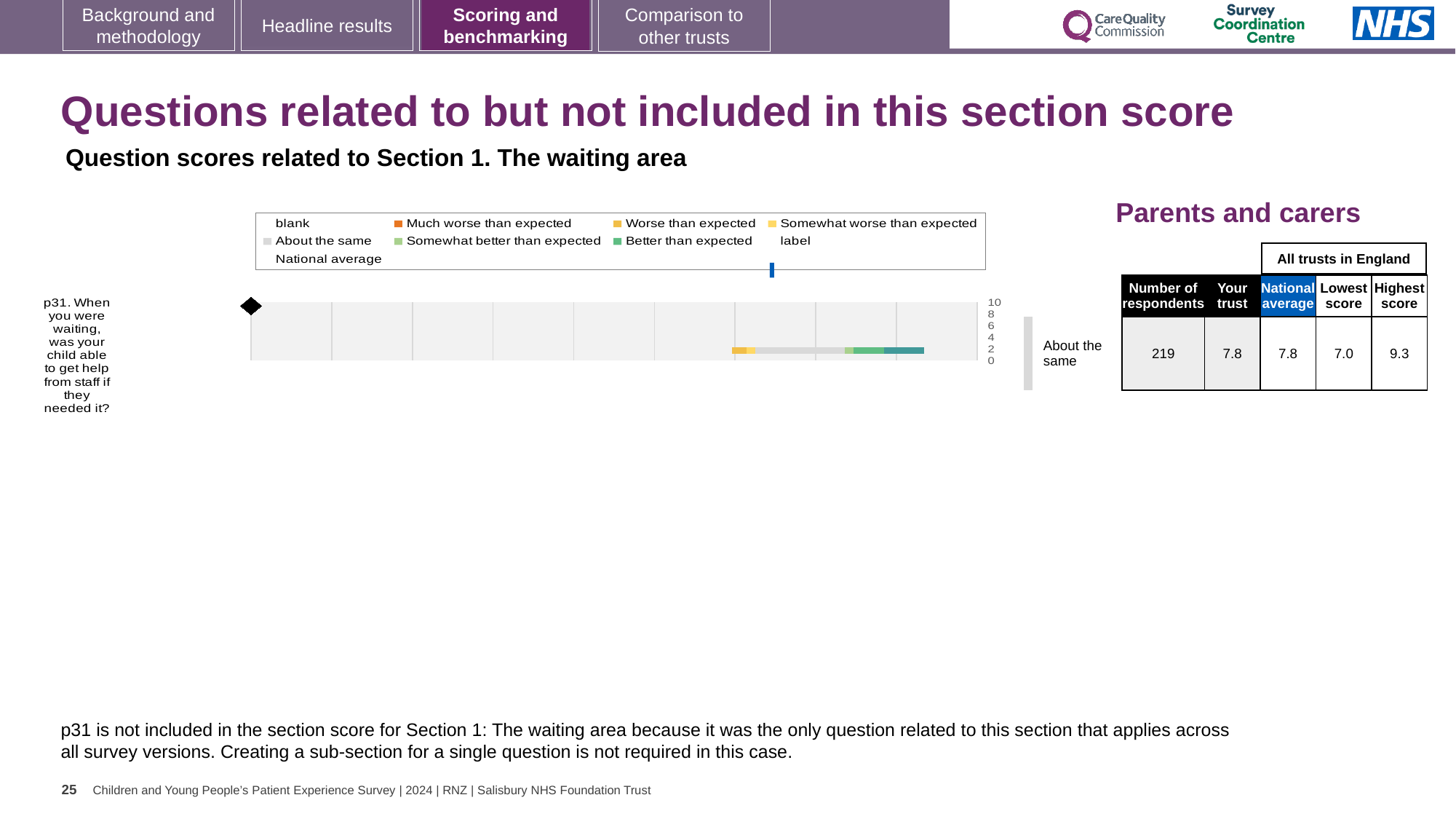
According to the table beside the chart, what is the National average score for p31? 7.8 What is the difference between the Highest score and the Your trust score for p31? 1.5 How many respondents answered question p31? 219 What is the subtitle above the chart describing which section the question scores relate to? Question scores related to Section 1. The waiting area What kind of chart is used to show the score for question p31? bar chart What is the difference between the Highest score and the Lowest score for p31? 2.3 According to the table beside the chart, what is the Lowest score among all trusts in England for p31? 7.0 What benchmark label is shown to the right of the bar for p31? About the same According to the table beside the chart, what is the Highest score among all trusts in England for p31? 9.3 Is the Your trust score for p31 higher than, lower than, or the same as the National average? the same According to the table beside the chart, what is the score for Your trust on p31? 7.8 How many questions are plotted in the chart? 1